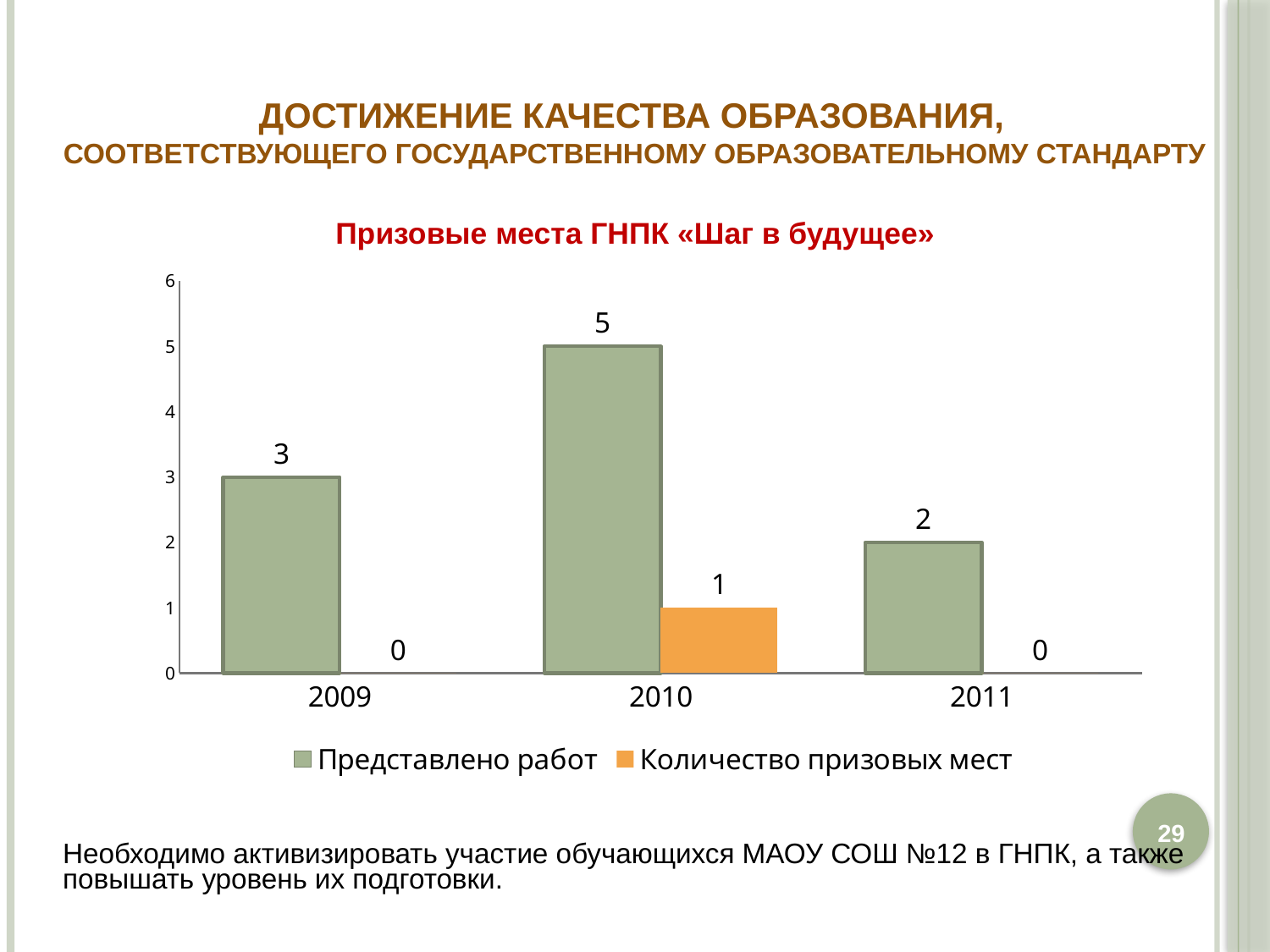
What is the value of "Представлено работ" for 2010? 5 What is the value of "Количество призовых мест" for 2009? 0 What is the title of the chart? Призовые места ГНПК «Шаг в будущее» In which year is "Представлено работ" highest? 2010 How many series does the legend list? 2 What is the value of "Количество призовых мест" for 2010? 1 What is the value of "Представлено работ" for 2011? 2 How many years are shown on the x axis? 3 What kind of chart is shown? Bar chart What is the difference between "Представлено работ" in 2010 and 2009? 2 In which year is "Представлено работ" lowest? 2011 Which is larger: "Представлено работ" in 2009 or in 2011? 2009